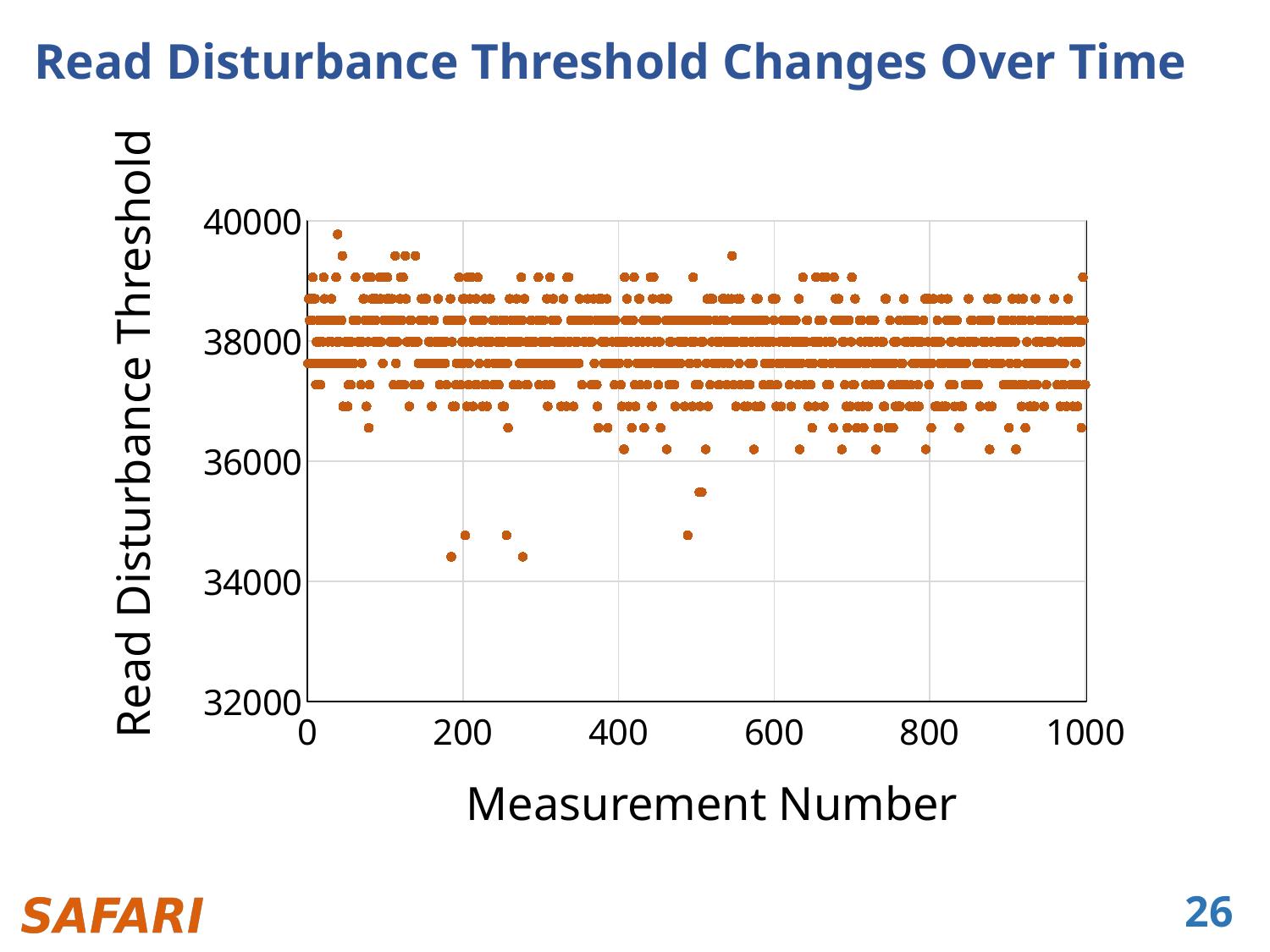
Is the highest plotted Read Disturbance Threshold value greater or less than 39000? greater Are any plotted points above 40000 on the y axis? no What kind of chart is shown on the slide? scatter chart Do the Read Disturbance Threshold values show a clear rise or fall as the Measurement Number increases from 0 to 1000? no, they stay roughly flat What is the title of the chart? Read Disturbance Threshold Changes Over Time What is the label of the x axis? Measurement Number Are most of the plotted points between 36000 and 40000 on the y axis? yes